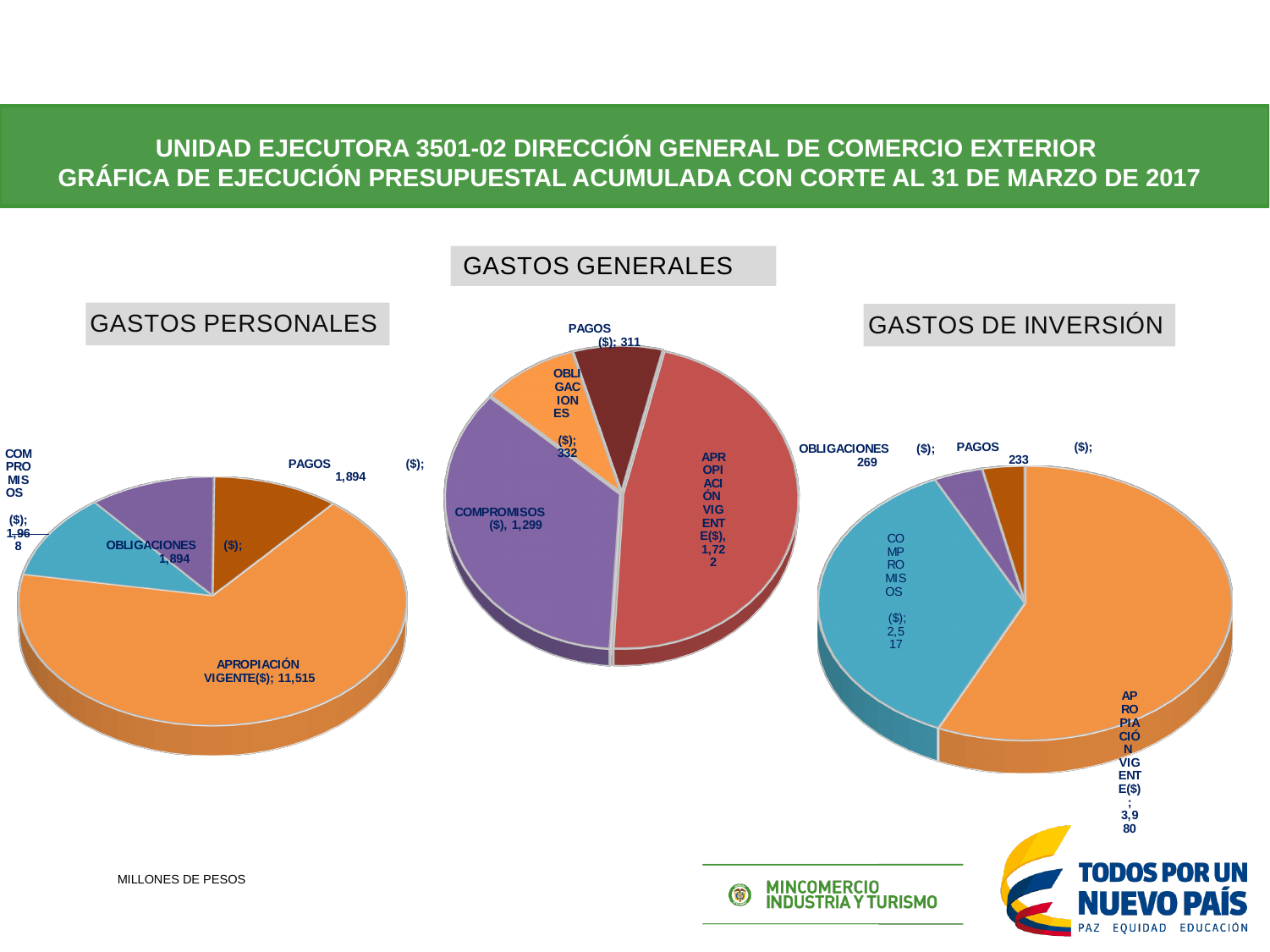
In the GASTOS DE INVERSIÓN chart, which category has the largest slice? APROPIACIÓN VIGENTE In the GASTOS GENERALES chart, what is the value for PAGOS? 311 What type of chart is used for GASTOS DE INVERSIÓN? Pie chart In the GASTOS GENERALES chart, what is the difference between OBLIGACIONES and PAGOS? 21 In the GASTOS DE INVERSIÓN chart, what is the difference between APROPIACIÓN VIGENTE and COMPROMISOS? 1,463 In the GASTOS GENERALES chart, what is the value for COMPROMISOS? 1,299 In the GASTOS DE INVERSIÓN chart, what is the value for OBLIGACIONES? 269 In the GASTOS PERSONALES chart, which is larger, COMPROMISOS or OBLIGACIONES? COMPROMISOS In the GASTOS PERSONALES chart, what is the value for APROPIACIÓN VIGENTE? 11,515 In the GASTOS GENERALES chart, which category has the smallest slice? PAGOS How many slices does the GASTOS GENERALES chart have? 4 In the GASTOS PERSONALES chart, what is the value for COMPROMISOS? 1,968